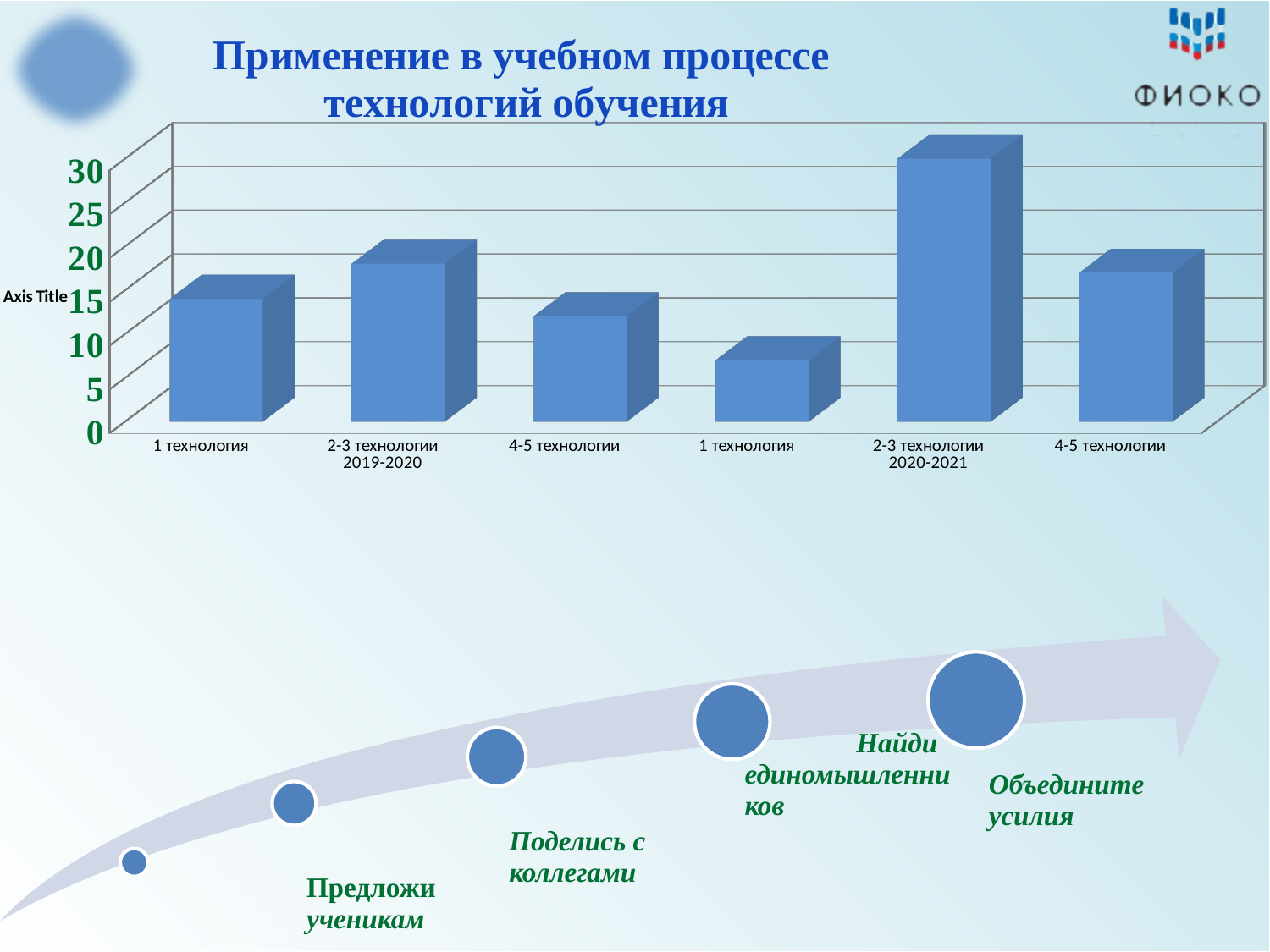
What is the highest tick value shown on the vertical axis of the chart? 30 Is the value for 2-3 технологии in 2020-2021 greater or less than 25? greater Is the value for 1 технология in 2020-2021 greater or less than 10? less Which category has the highest bar in the chart? 2-3 технологии (2020-2021) Which is larger: the bar for 2-3 технологии in 2019-2020 or the bar for 4-5 технологии in 2019-2020? 2-3 технологии (2019-2020) Which category has the lowest bar in the chart? 1 технология (2020-2021) What is the title of the chart on the slide? Применение в учебном процессе технологий обучения What kind of chart is shown on the slide? bar chart Which is larger: the bar for 1 технология in 2019-2020 or the bar for 1 технология in 2020-2021? 1 технология (2019-2020) Is the value for 2-3 технологии in 2019-2020 greater or less than 15? greater How many bars does the chart show? 6